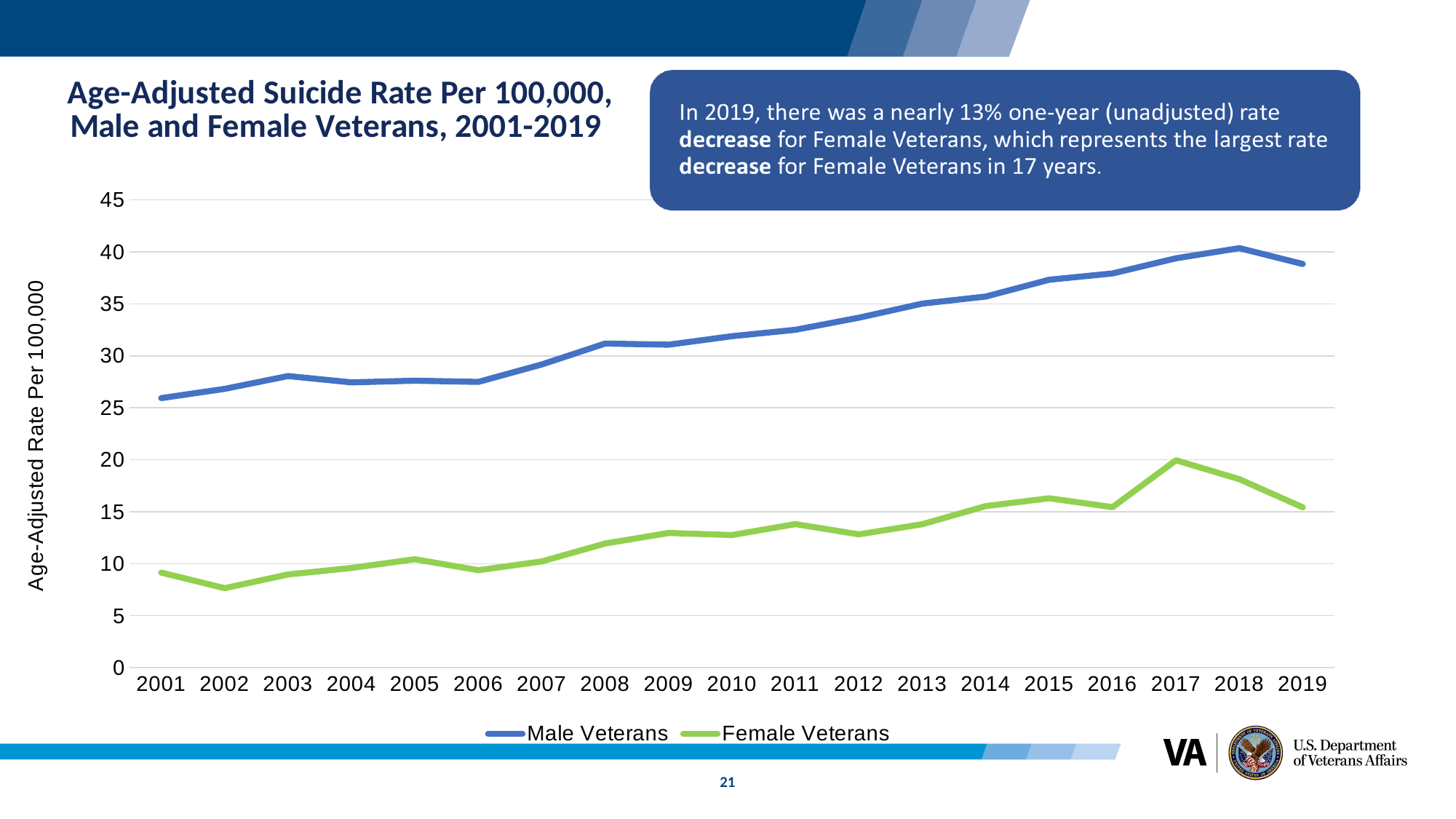
In which year is the Female Veterans rate highest? 2017 In which year is the Female Veterans rate lowest? 2002 Is the Male Veterans rate in 2008 greater or less than 30? greater In which year is the Male Veterans rate highest? 2018 In 2010, which series has the higher rate, Male Veterans or Female Veterans? Male Veterans In which year is the Male Veterans rate lowest? 2001 Does the Male Veterans rate generally rise or fall from 2001 to 2018? rise How many years are plotted along the x axis? 19 Is the Male Veterans rate in 2019 greater or less than 40? less How many series does the legend list? 2 Is the Female Veterans rate in 2002 greater or less than 10? less What kind of chart is shown on the slide? line chart